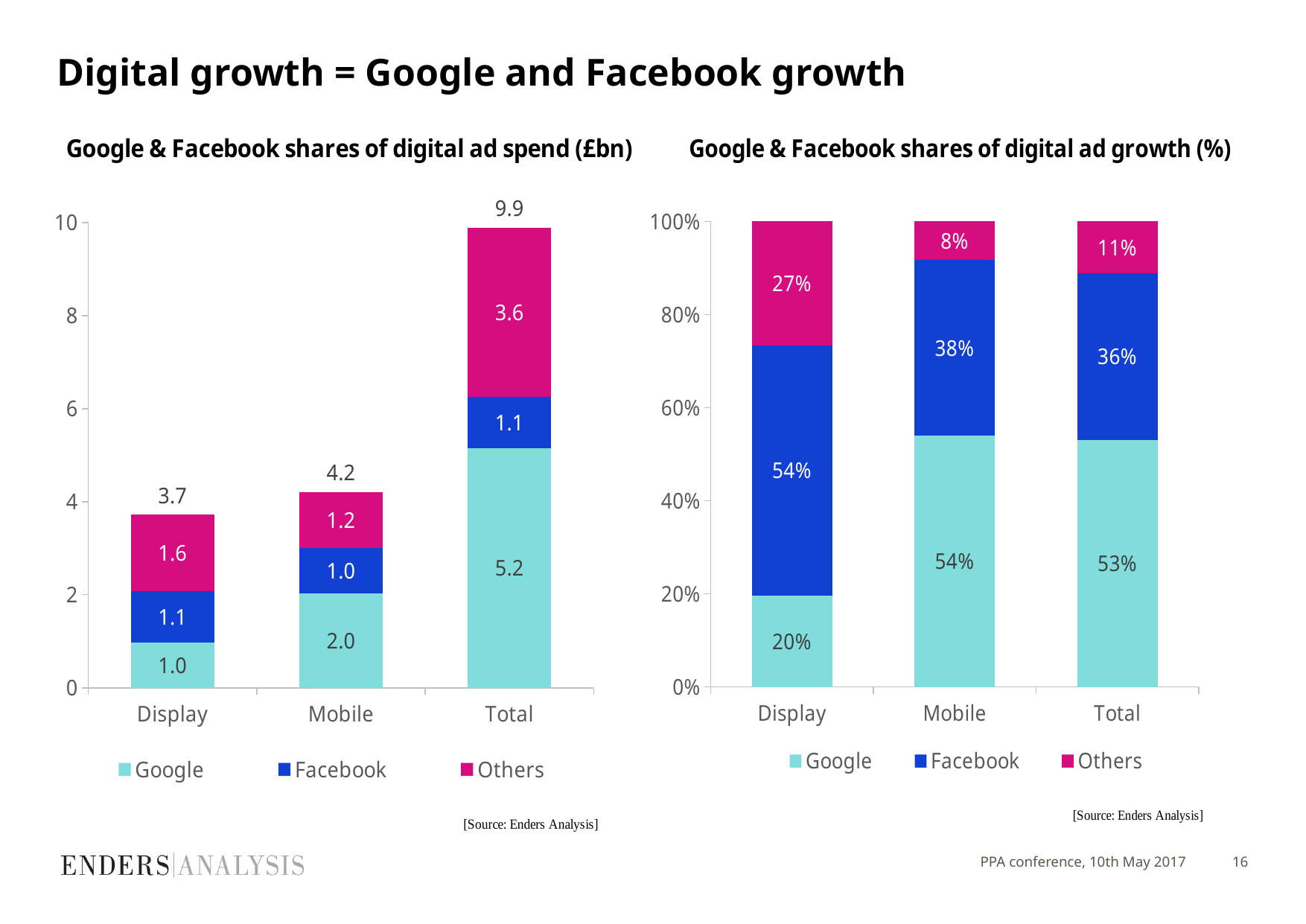
In the 'Google & Facebook shares of digital ad spend (£bn)' chart, what is the difference between the Google values for Total and Mobile? 3.2 In the 'Google & Facebook shares of digital ad growth (%)' chart, what is the value for Others in the Mobile category? 8% In the 'Google & Facebook shares of digital ad growth (%)' chart, which category has the lowest Google share? Display In the 'Google & Facebook shares of digital ad growth (%)' chart, what is the difference between the Others share for Display and for Total? 16% In the 'Google & Facebook shares of digital ad spend (£bn)' chart, which category has the highest stacked total? Total In the 'Google & Facebook shares of digital ad spend (£bn)' chart, what is the value for Google in the Mobile category? 2.0 In the 'Google & Facebook shares of digital ad growth (%)' chart, what is the value for Facebook in the Display category? 54% How many series does the legend of the 'Google & Facebook shares of digital ad growth (%)' chart list? 3 What kind of chart is the 'Google & Facebook shares of digital ad spend (£bn)' chart? Stacked bar chart In the 'Google & Facebook shares of digital ad spend (£bn)' chart, what is the value for Others in the Total category? 3.6 In the 'Google & Facebook shares of digital ad spend (£bn)' chart, which is larger for Display: the Facebook value or the Others value? Others In the 'Google & Facebook shares of digital ad spend (£bn)' chart, what is the total of the stacked bar for Display? 3.7